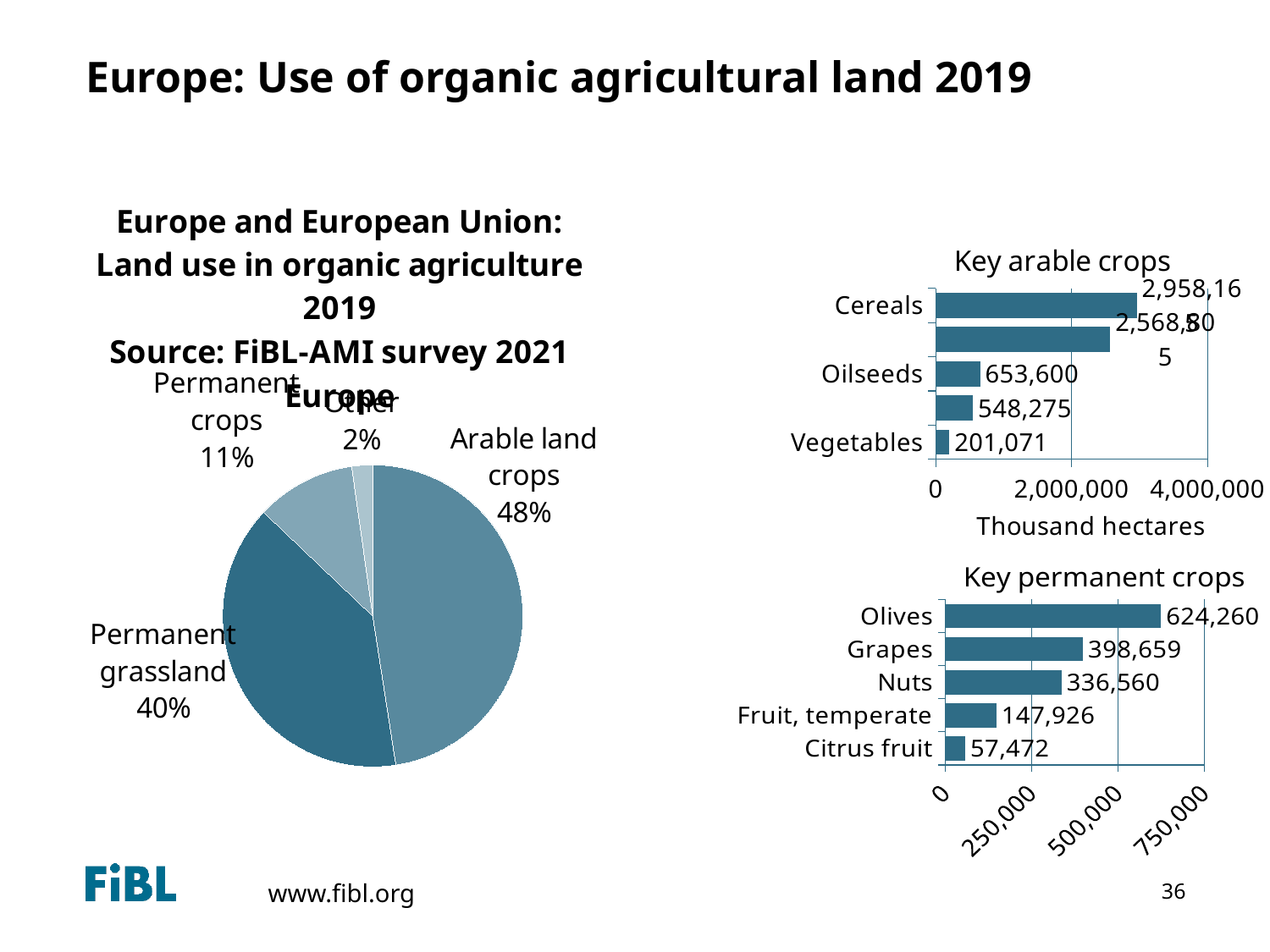
In the 'Key permanent crops' chart, which crop has the highest value? Olives In the pie chart on the left, which category has the smallest slice? Other In the 'Key arable crops' chart, what is the value for Oilseeds? 653,600 In the 'Key arable crops' chart, which is larger, Oilseeds or Vegetables? Oilseeds In the 'Key permanent crops' chart, what is the value for Citrus fruit? 57,472 In the pie chart on the left, which category has the largest slice? Arable land crops In the 'Key permanent crops' chart, what is the difference between Olives and Grapes? 225,601 In the pie chart 'Europe and European Union: Land use in organic agriculture 2019', what share is Arable land crops? 48% In the pie chart on the left, what share is Permanent grassland? 40% In the 'Key permanent crops' chart, what is the value for Olives? 624,260 What kind of chart is the chart on the left of the slide? Pie chart How many crop categories are shown in the 'Key permanent crops' chart? 5